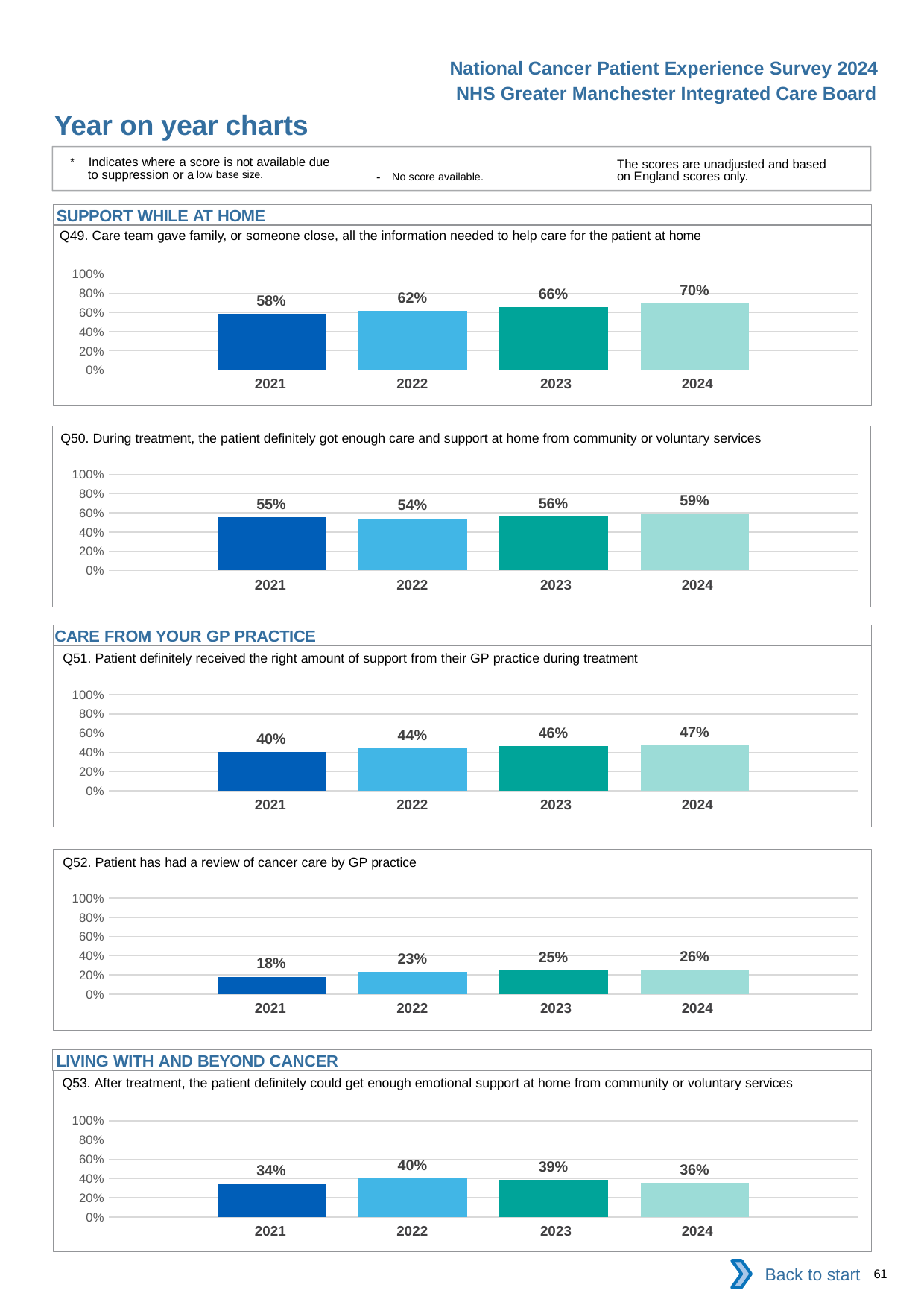
In the Q51 chart, what is the difference between the 2024 and 2021 values? 7% How many years are shown in the Q50 chart? 4 In the Q53 chart, which year has the highest value? 2022 In the Q49 chart, what is the value for 2024? 70% Which section heading appears above the Q51 chart? CARE FROM YOUR GP PRACTICE In the Q52 chart, what is the difference between the 2022 and 2021 values? 5% In the Q52 chart, what is the value for 2021? 18% What kind of chart is the Q52 chart? bar chart In the Q53 chart, is the value for 2023 or 2024 larger? 2023 In the Q50 chart, which year has the lowest value? 2022 In the Q49 chart, do the values rise or fall from 2021 to 2024? rise In the Q50 chart, what is the value for 2023? 56%